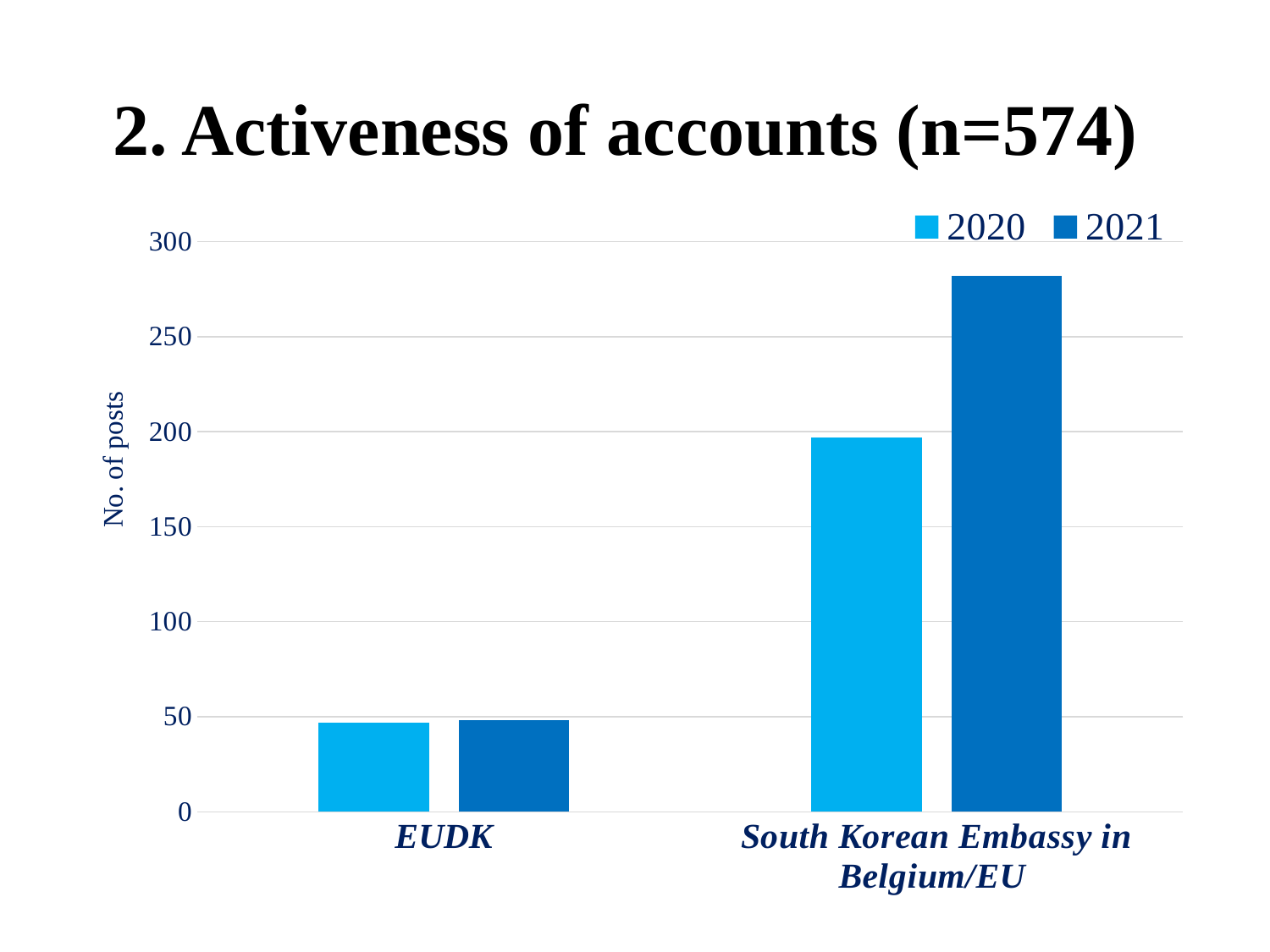
Is the 2021 value for South Korean Embassy in Belgium/EU greater or less than 250? greater How many categories are shown on the x axis? 2 Which category has the highest number of posts in 2021? South Korean Embassy in Belgium/EU Which category has the lowest number of posts in 2020? EUDK Is the 2021 value for EUDK greater or less than 100? less What is the label of the y axis? No. of posts How many series does the legend list? 2 What is the title of the slide? 2. Activeness of accounts (n=574) What kind of chart is shown on the slide? bar chart For South Korean Embassy in Belgium/EU, which year has more posts, 2020 or 2021? 2021